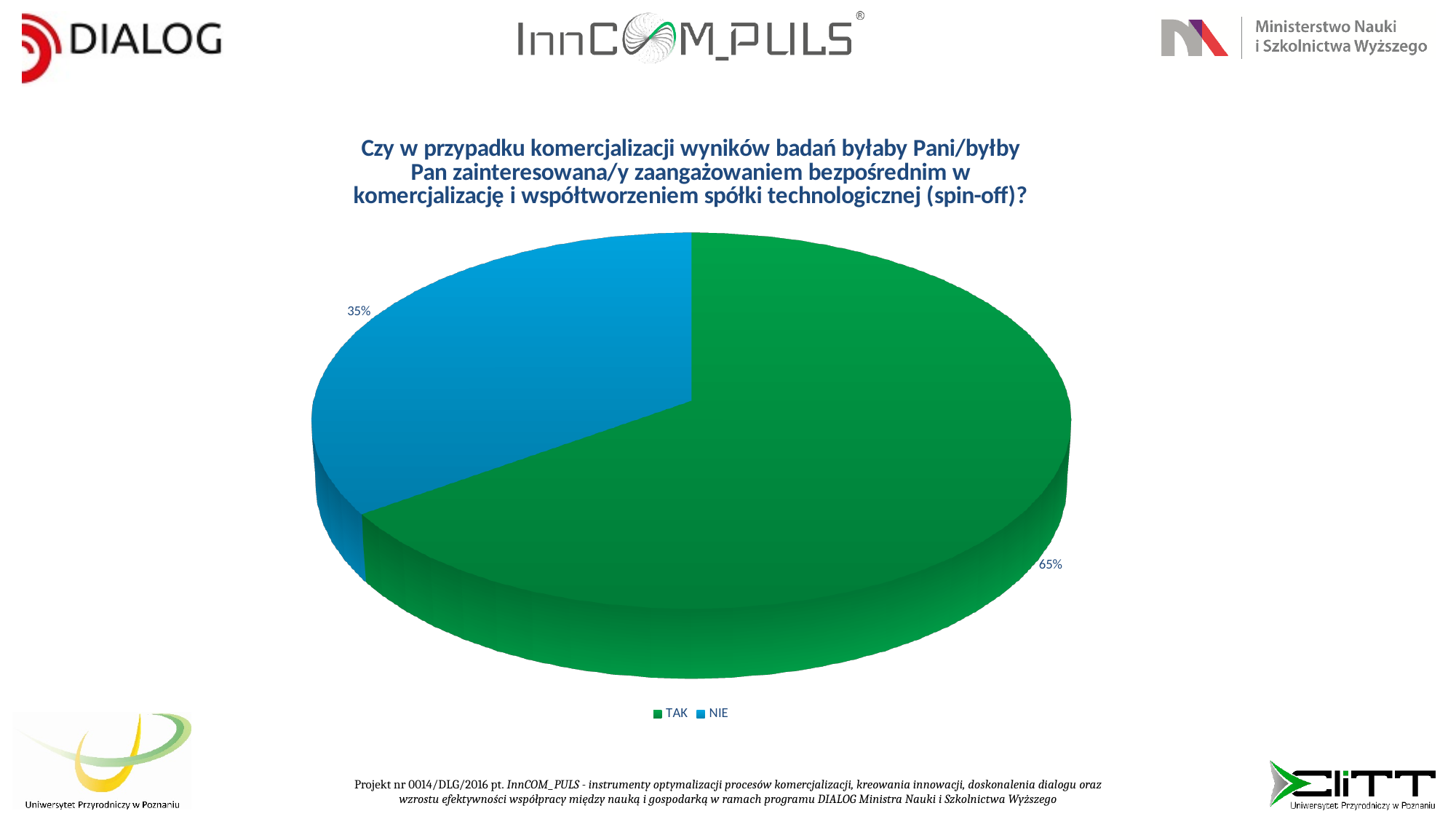
What colour is the TAK slice? green Which category has the largest slice of the pie? TAK What is the difference in percentage points between the TAK and NIE slices? 30 What share of the pie does TAK represent? 65% What kind of chart is shown on the slide? pie chart How many entries does the legend list? 2 Which category has the smallest slice of the pie? NIE How many slices does the pie chart have? 2 What share of the pie does NIE represent? 35% What colour is the NIE slice? blue Which slice is larger, TAK or NIE? TAK